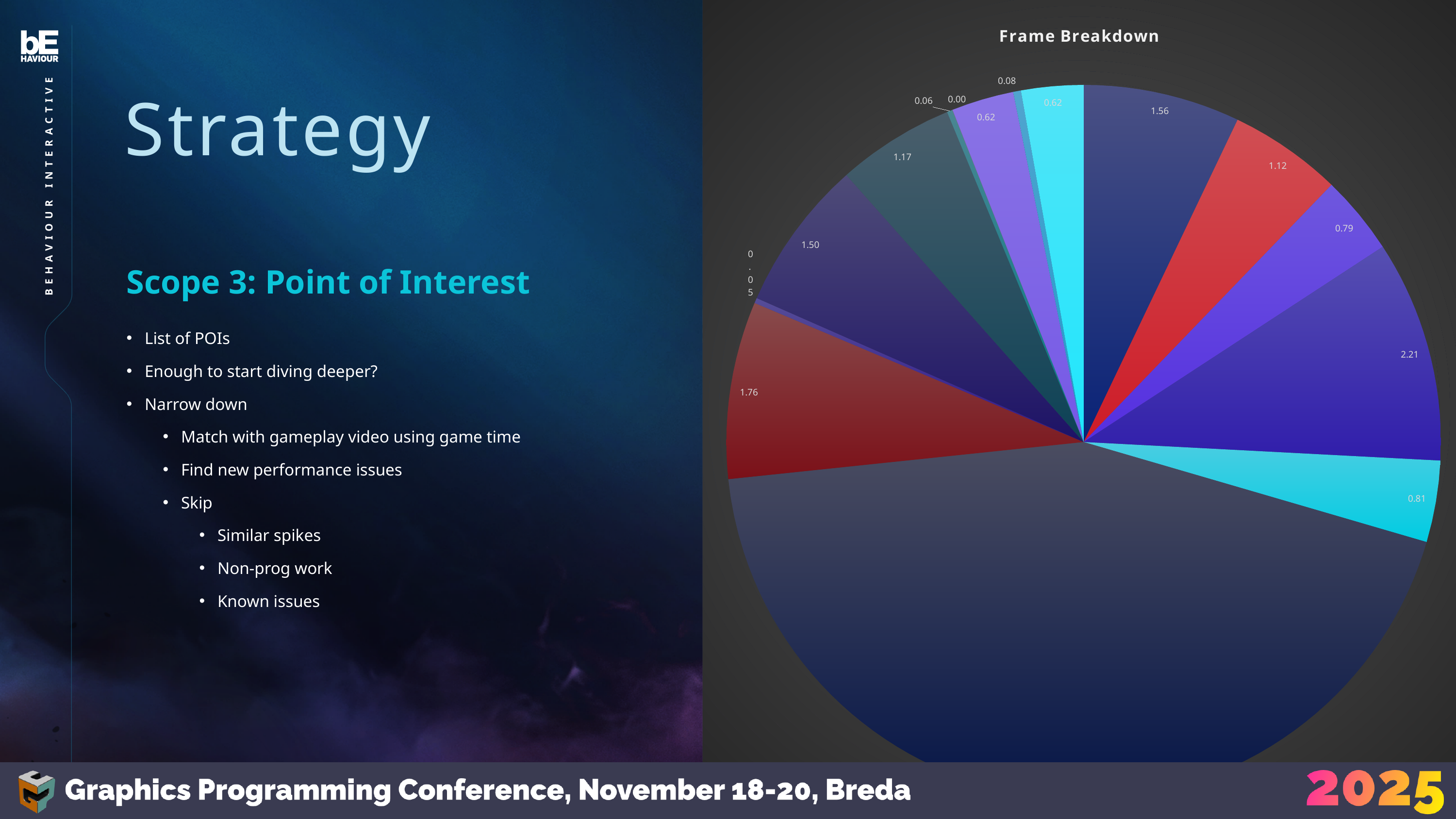
What value is labelled on the teal slice in the upper left of the pie chart? 1.17 What value is labelled on the red slice on the left side of the pie chart? 1.76 What value is labelled on the cyan slice on the right side of the pie chart? 0.81 Is the value of the purple slice on the right side of the pie chart (labelled 0.79) greater or less than 1? less What is the largest value printed as a data label on the pie chart? 2.21 What is the difference between the slice labelled 2.21 and the slice labelled 1.76? 0.45 What value is labelled on the dark blue slice at the top right, next to the cyan slice at the top? 1.56 What is the smallest value printed as a data label on the pie chart? 0.00 What is the title of the chart? Frame Breakdown What kind of chart is shown on the slide? pie chart Which red slice is larger: the one on the left (1.76) or the one in the upper right (1.12)? the one on the left (1.76) What value is labelled on the red slice in the upper right of the pie chart? 1.12